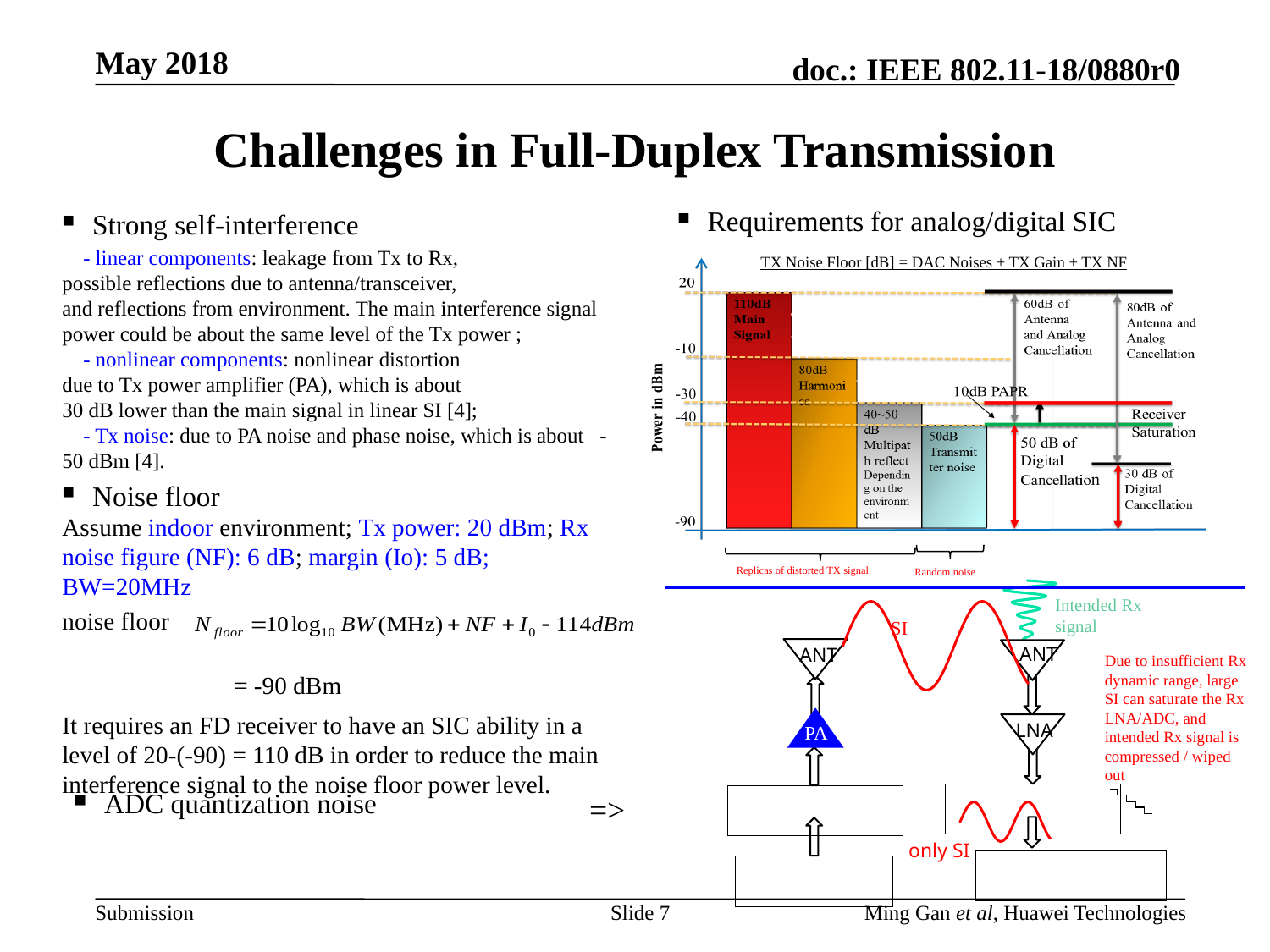
What kind of chart is shown on the right side of the slide under 'Requirements for analog/digital SIC'? bar chart What value is labelled on the Transmitter noise bar in the power chart? 50dB What value is labelled on the Harmonics bar in the power chart? 80dB In the power chart, which is larger: the Harmonics bar or the Transmitter noise bar? Harmonics What value is labelled on the Main Signal bar in the power chart? 110dB What value is labelled on the Multipath reflect bar in the power chart? 40~50 dB In the power chart, what is the difference between the Harmonics value and the Transmitter noise value? 30dB Which bar in the power chart has the highest value? Main Signal In the power chart, is the top of the Main Signal bar greater or less than -10 on the vertical axis? greater In the power chart, what is the difference between the Main Signal value and the Harmonics value? 30dB What is the label of the vertical axis in the power chart? Power in dBm How many bars are plotted in the power chart? 4